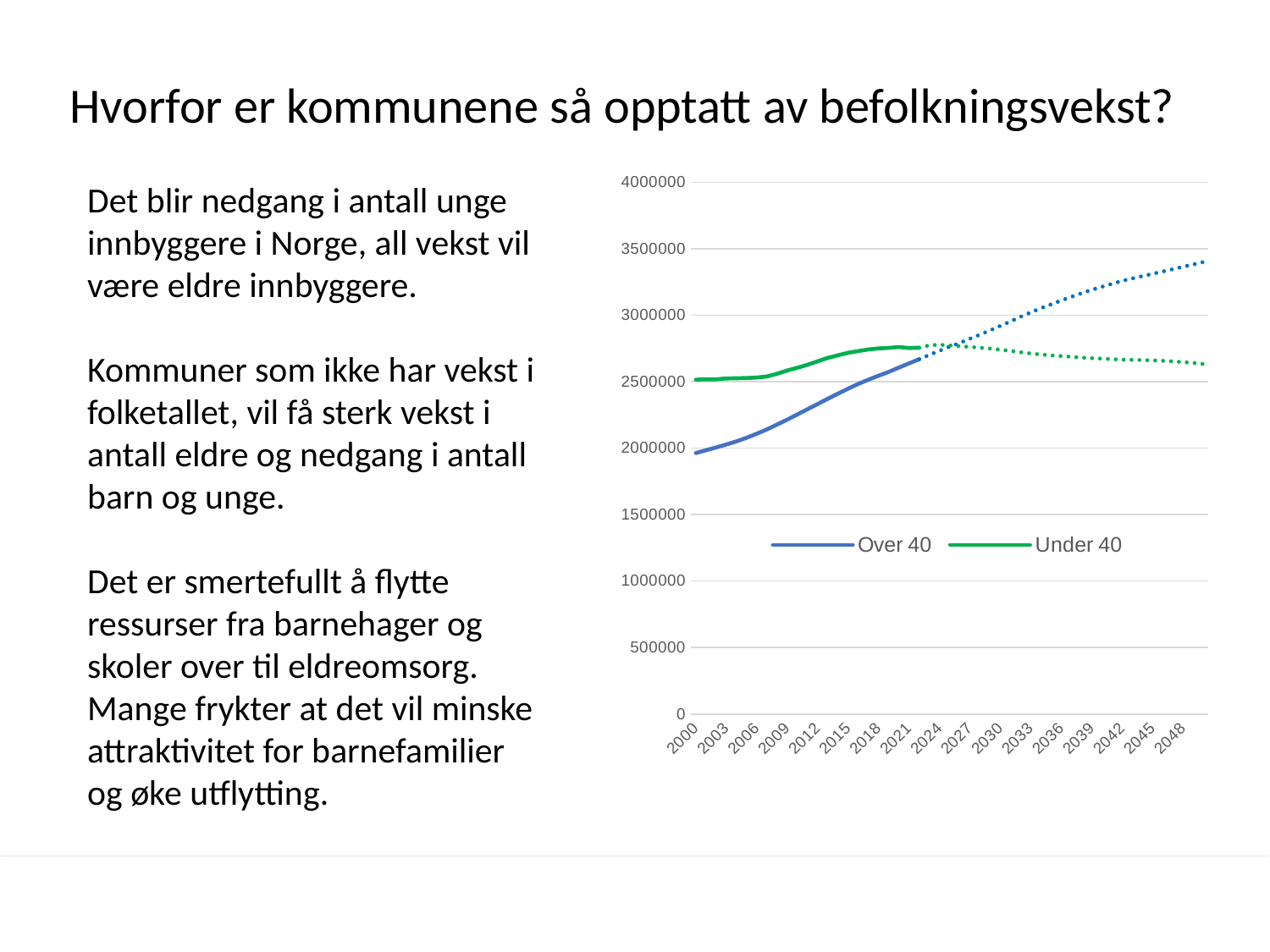
How many series does the chart legend list? 2 Is the value for Under 40 in 2048 greater or less than 3000000? less In 2048, which series has the larger value, Over 40 or Under 40? Over 40 Which colour is used for the Under 40 series? green Does the Over 40 series rise or fall from 2000 to 2048? rise In 2000, which series has the larger value, Over 40 or Under 40? Under 40 What are the two series named in the chart legend? Over 40 and Under 40 Is the value for Under 40 in 2021 greater or less than 2500000? greater Is the value for Over 40 in 2048 greater or less than 3000000? greater What kind of chart is shown on the slide? line chart How many year labels are shown on the x axis? 17